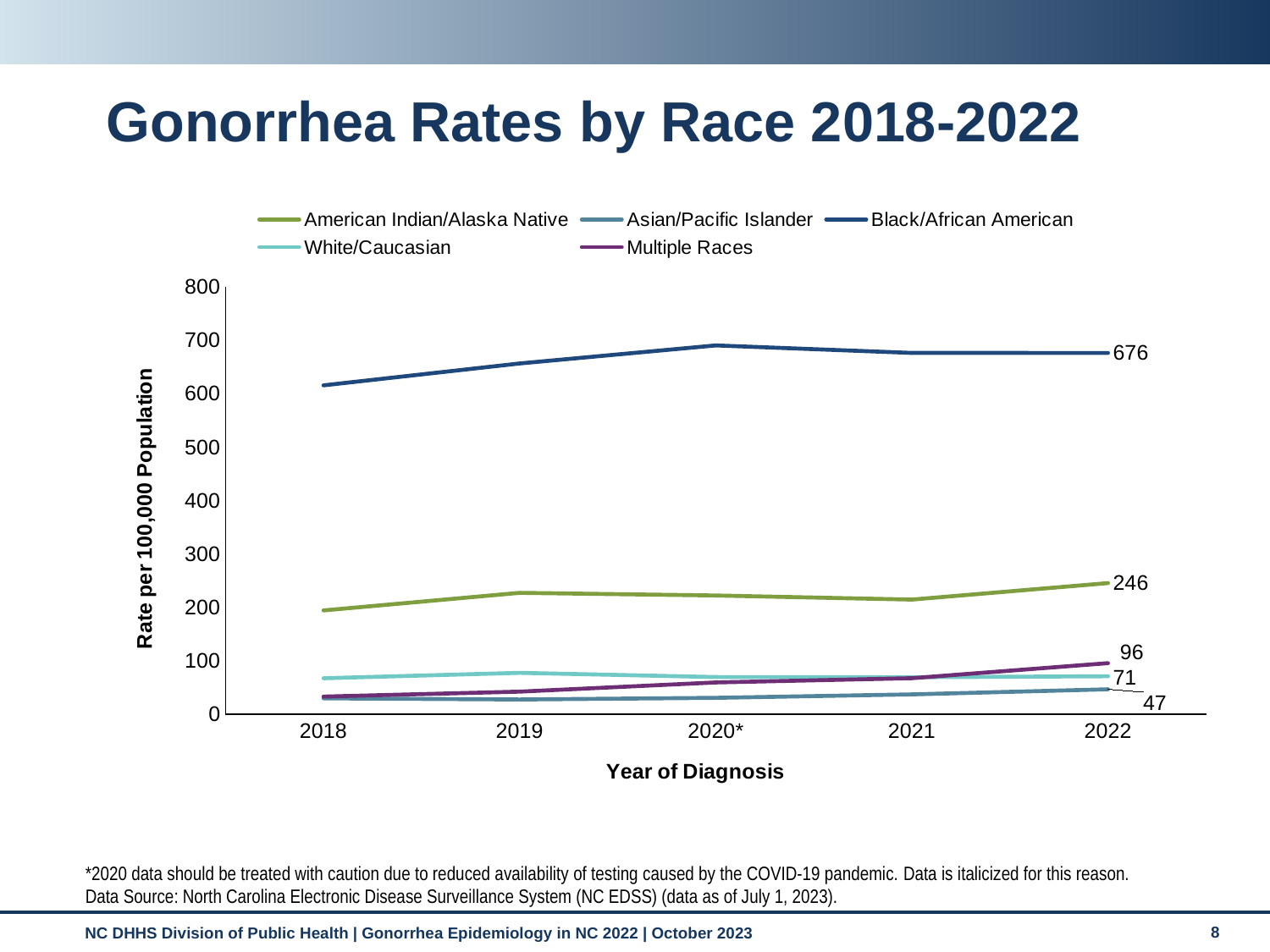
Which race group has the lowest gonorrhea rate in 2022? Asian/Pacific Islander How many series does the legend list? 5 What is the difference between the 2022 rates for Black/African American and American Indian/Alaska Native? 430 Which race group has the highest gonorrhea rate in 2022? Black/African American In 2022, which is larger: the rate for Multiple Races or the rate for White/Caucasian? Multiple Races What is the gonorrhea rate for Black/African American in 2022? 676 What kind of chart is shown on the slide? line chart What is the gonorrhea rate for Asian/Pacific Islander in 2022? 47 Is the rate for Black/African American in 2018 greater or less than 700? less What is the gonorrhea rate for White/Caucasian in 2022? 71 What is the gonorrhea rate for Multiple Races in 2022? 96 What is the gonorrhea rate for American Indian/Alaska Native in 2022? 246